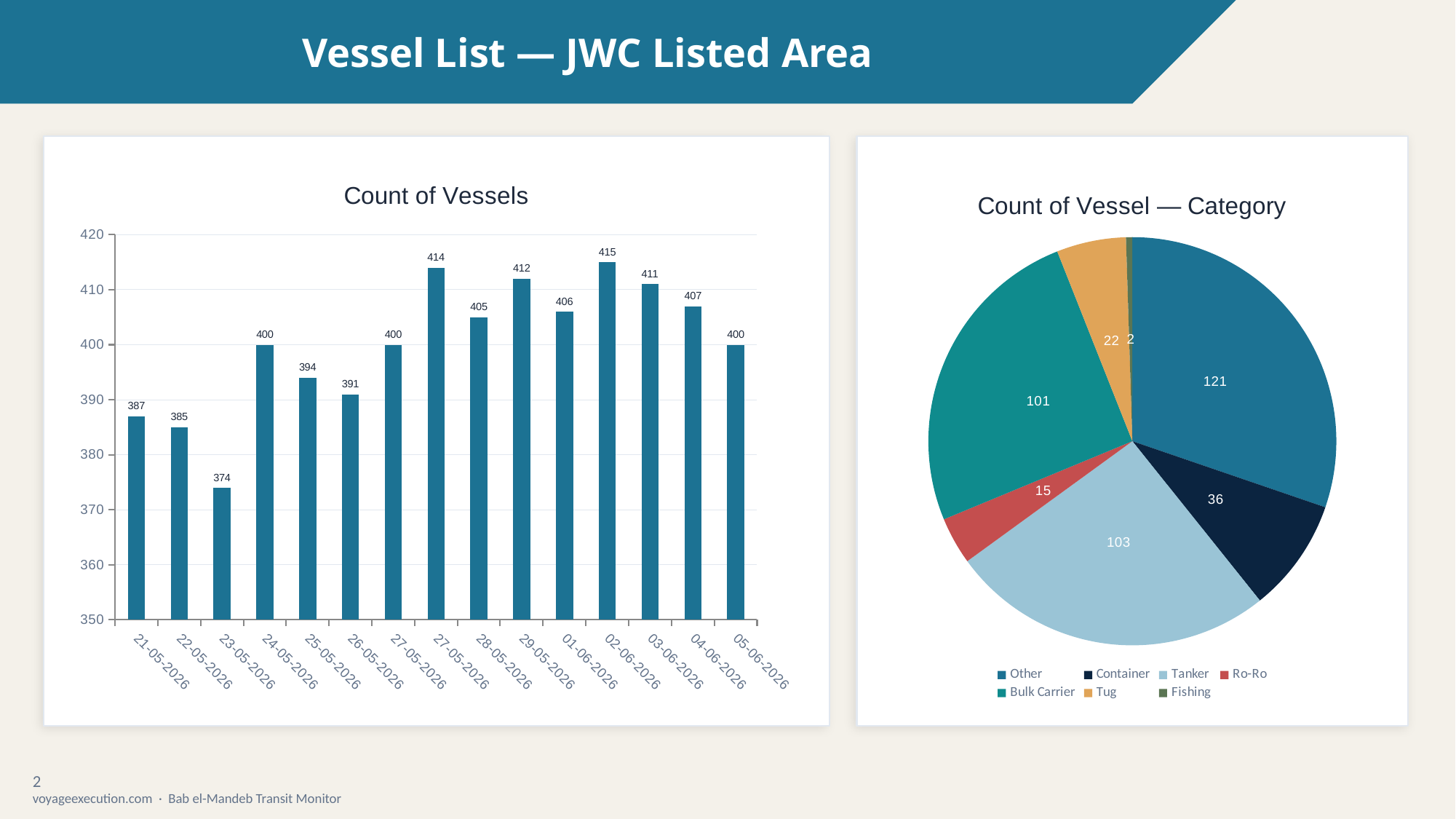
In the 'Count of Vessel — Category' pie chart, which category has the largest slice? Other In the 'Count of Vessels' chart, what is the value for 23-05-2026? 374 In the 'Count of Vessel — Category' pie chart, how many categories does the legend list? 7 In the 'Count of Vessels' chart, which date has the highest count? 02-06-2026 In the 'Count of Vessels' chart, which date has the lowest count? 23-05-2026 In the 'Count of Vessels' chart, what is the value for 02-06-2026? 415 In the 'Count of Vessel — Category' pie chart, what is the difference between the values for Bulk Carrier and Container? 65 In the 'Count of Vessels' chart, what is the difference between the values for 29-05-2026 and 21-05-2026? 25 What kind of chart is 'Count of Vessels'? Bar chart In the 'Count of Vessels' chart, how many bars are plotted? 15 In the 'Count of Vessel — Category' pie chart, what is the value for Tanker? 103 In the 'Count of Vessels' chart, which is larger: the value for 03-06-2026 or the value for 04-06-2026? 03-06-2026